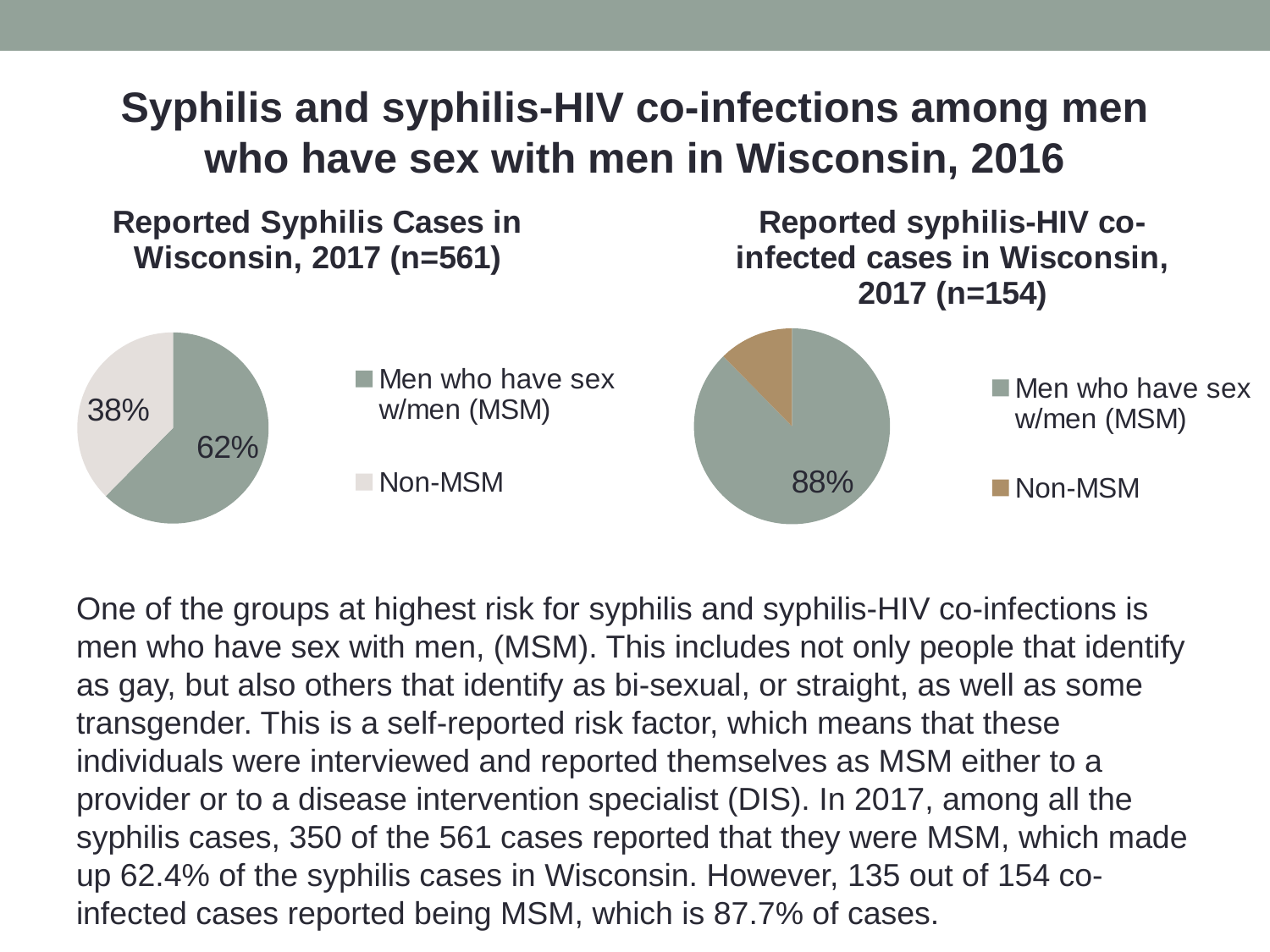
In the right pie chart, which category has the larger slice? Men who have sex w/men (MSM) In the left pie chart, what is the difference in percentage points between the MSM slice and the Non-MSM slice? 24 How many categories does the legend of the right pie chart list? 2 In the chart titled "Reported Syphilis Cases in Wisconsin, 2017 (n=561)", what share of cases is labelled for men who have sex with men (MSM)? 62% In the chart titled "Reported Syphilis Cases in Wisconsin, 2017 (n=561)", what share of cases is labelled for Non-MSM? 38% In the left pie chart, which category has the larger slice? Men who have sex w/men (MSM) What is the sample size (n) shown in the title of the right pie chart? 154 What is the sample size (n) shown in the title of the left pie chart? 561 In the chart titled "Reported syphilis-HIV co-infected cases in Wisconsin, 2017 (n=154)", what share of cases is labelled for men who have sex with men (MSM)? 88% In the left pie chart, which category has the smaller slice? Non-MSM What type of chart is used for the reported syphilis cases in Wisconsin, 2017? Pie chart Is the MSM share larger in the left pie chart or in the right pie chart? Right pie chart